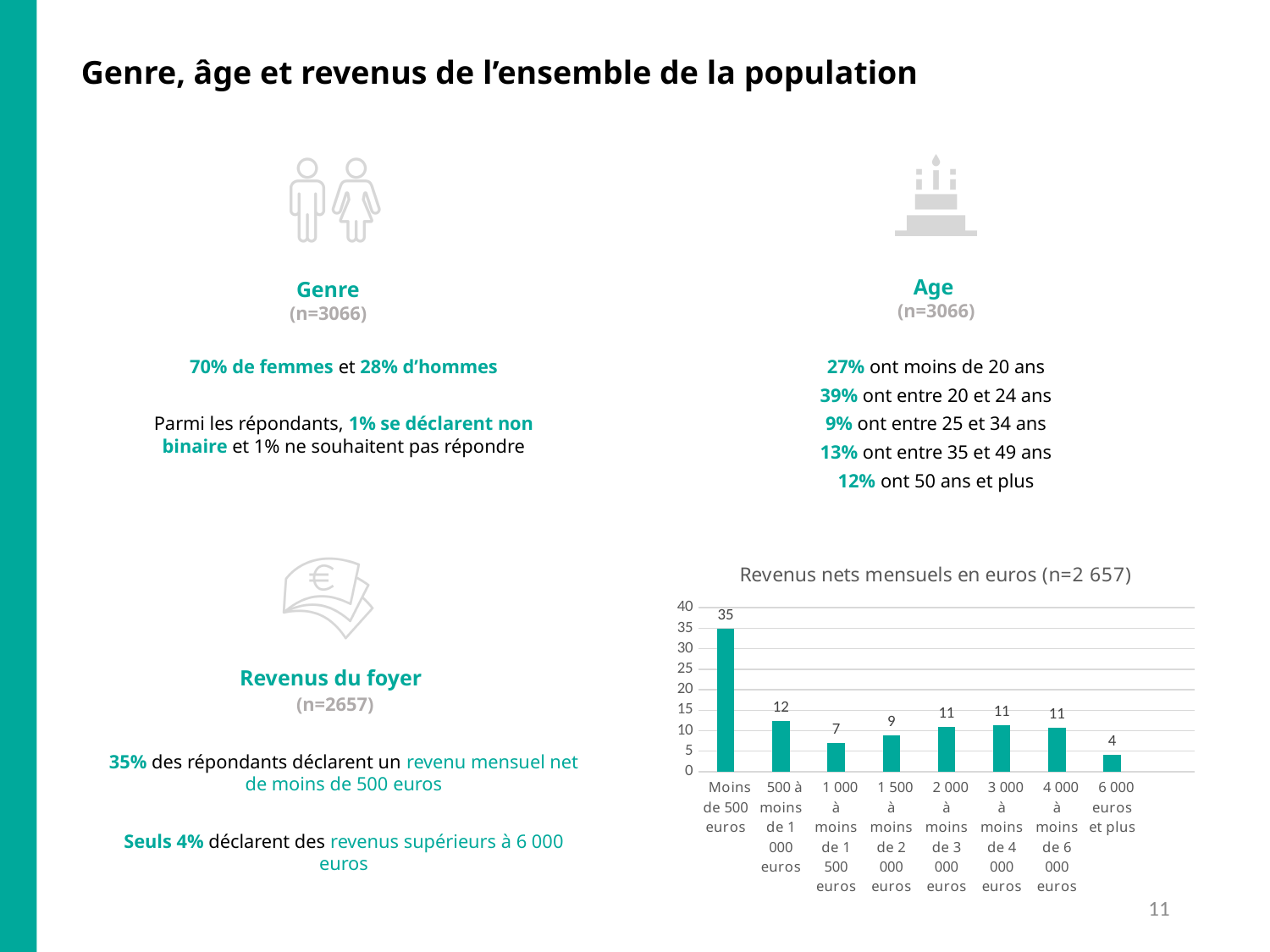
What type of chart is the 'Revenus nets mensuels en euros' chart? bar chart What is the title of the chart on the slide? Revenus nets mensuels en euros (n=2 657) What is the value for the 'Moins de 500 euros' category in the 'Revenus nets mensuels en euros' chart? 35 What is the value for the '1 000 à moins de 1 500 euros' category in the 'Revenus nets mensuels en euros' chart? 7 Which category has the lowest value in the 'Revenus nets mensuels en euros' chart? 6 000 euros et plus What is the value for the '500 à moins de 1 000 euros' category in the 'Revenus nets mensuels en euros' chart? 12 In the 'Revenus nets mensuels en euros' chart, which is larger: the value for '1 500 à moins de 2 000 euros' or the value for '1 000 à moins de 1 500 euros'? 1 500 à moins de 2 000 euros In the 'Revenus nets mensuels en euros' chart, is the value for 'Moins de 500 euros' greater or less than 30? greater What is the value for the '6 000 euros et plus' category in the 'Revenus nets mensuels en euros' chart? 4 Which category has the highest value in the 'Revenus nets mensuels en euros' chart? Moins de 500 euros In the 'Revenus nets mensuels en euros' chart, what is the difference between the values for 'Moins de 500 euros' and '500 à moins de 1 000 euros'? 23 How many categories are shown in the 'Revenus nets mensuels en euros' chart? 8